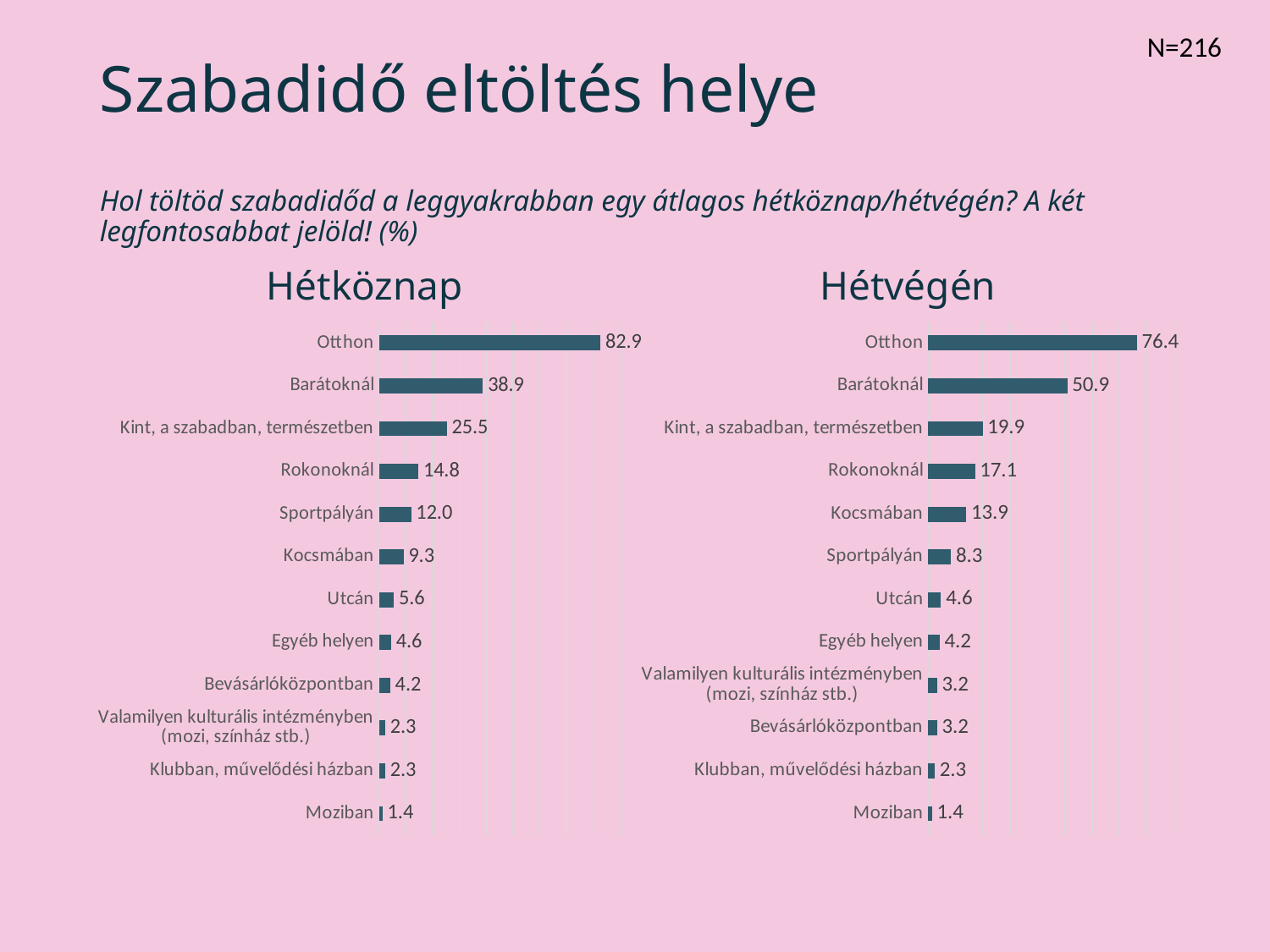
What is the sample size (N) shown on the slide? N=216 In the Hétköznap chart, what is the difference between Otthon and Barátoknál? 44.0 In the Hétköznap chart, what is the value for Otthon? 82.9 What type of chart is the Hétköznap chart? Bar chart In the Hétköznap chart, which category has the lowest value? Moziban In the Hétvégén chart, what is the value for Barátoknál? 50.9 In the Hétvégén chart, what is the value for Kocsmában? 13.9 In the Hétköznap chart, what is the value for Sportpályán? 12.0 Which is larger: Kint, a szabadban, természetben in the Hétköznap chart or in the Hétvégén chart? Hétköznap In the Hétvégén chart, what is the difference between Rokonoknál and Sportpályán? 8.8 In the Hétvégén chart, which category has the highest value? Otthon How many categories does the Hétvégén chart show? 12